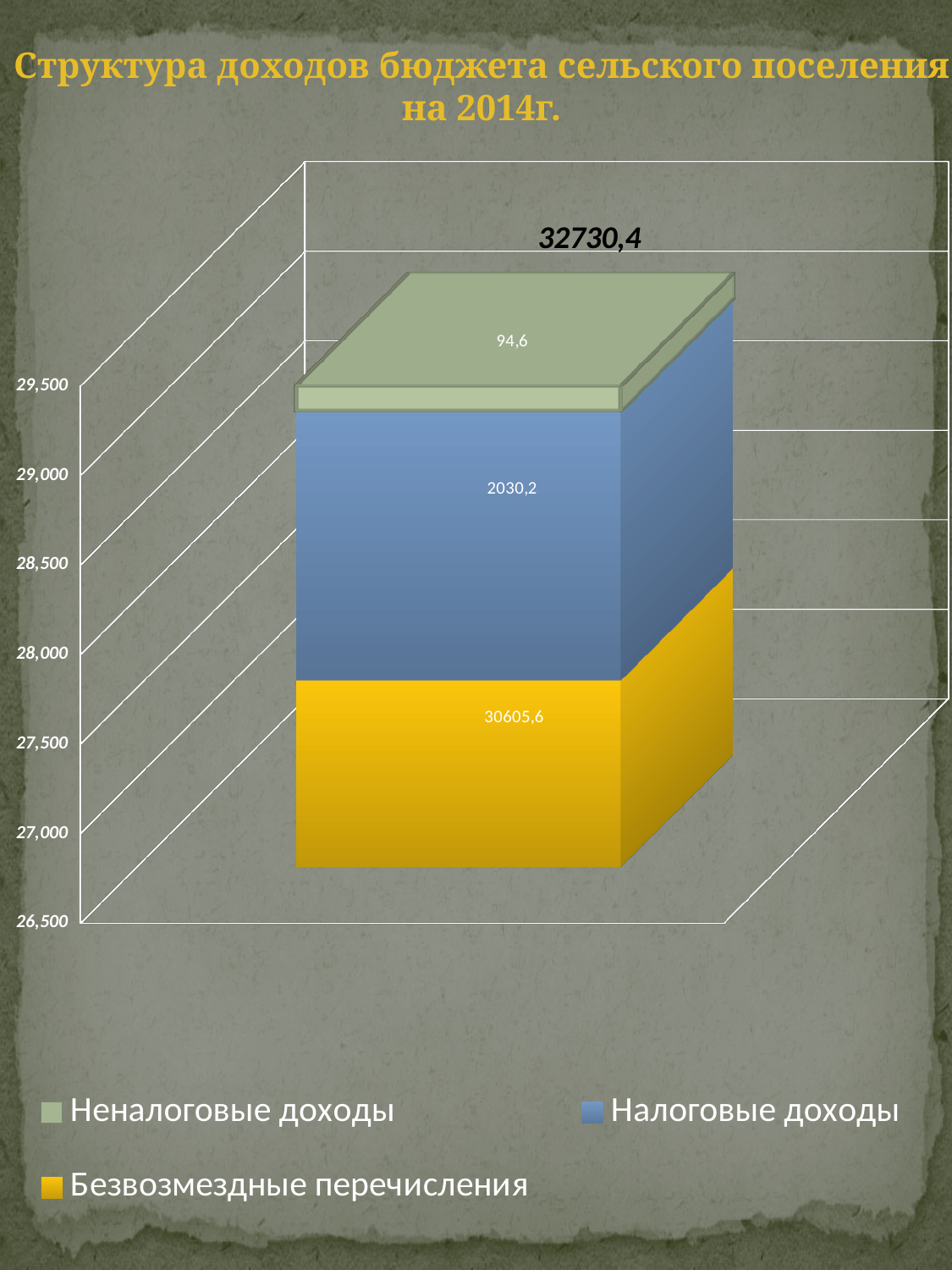
What is the title of the chart? Структура доходов бюджета сельского поселения на 2014г. What kind of chart is shown on the slide? Stacked bar chart What is the value shown for Неналоговые доходы? 94,6 What is the value shown for Безвозмездные перечисления? 30605,6 What is the total of the stacked bar, as labelled above it? 32730,4 Which colour represents Безвозмездные перечисления in the legend? Yellow How many series does the legend list? 3 What is the difference between Налоговые доходы and Неналоговые доходы? 1935,6 Which is larger, Налоговые доходы or Неналоговые доходы? Налоговые доходы Which series has the largest value in the bar? Безвозмездные перечисления What is the value shown for Налоговые доходы? 2030,2 Which series has the smallest value in the bar? Неналоговые доходы